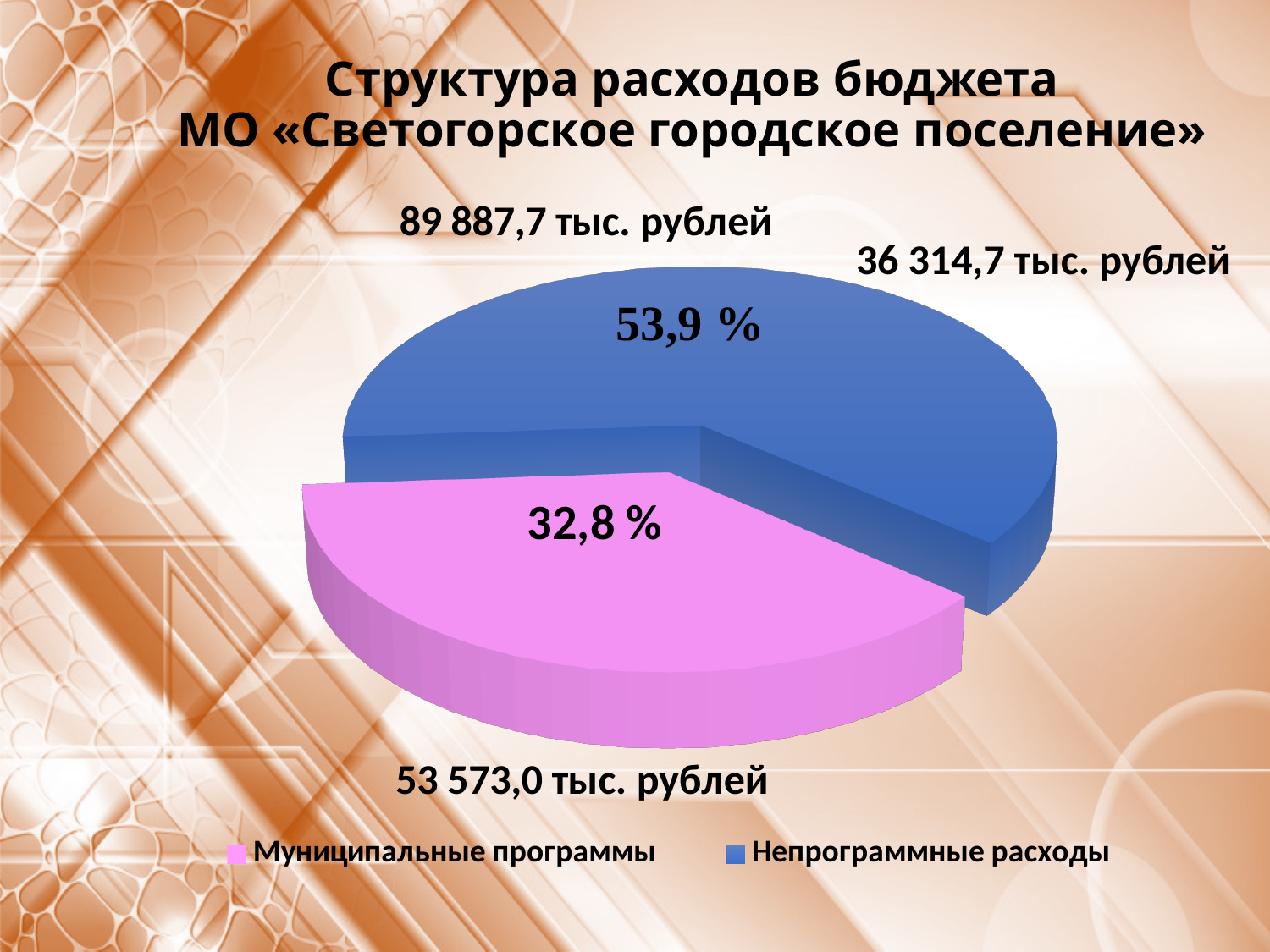
Which category has the smaller percentage label on the pie chart? Муниципальные программы What kind of chart is shown on the slide? Pie chart What percentage is shown on the slice for Муниципальные программы? 32,8 % What percentage is shown on the slice for Непрограммные расходы? 53,9 % How many slices does the pie chart have? 2 What colour is the slice for Муниципальные программы? Pink Is the percentage label for Непрограммные расходы greater or less than 50%? greater Which category has the larger percentage label on the pie chart? Непрограммные расходы How many entries does the legend list? 2 By how many percentage points does the label for Непрограммные расходы exceed the label for Муниципальные программы? 21,1